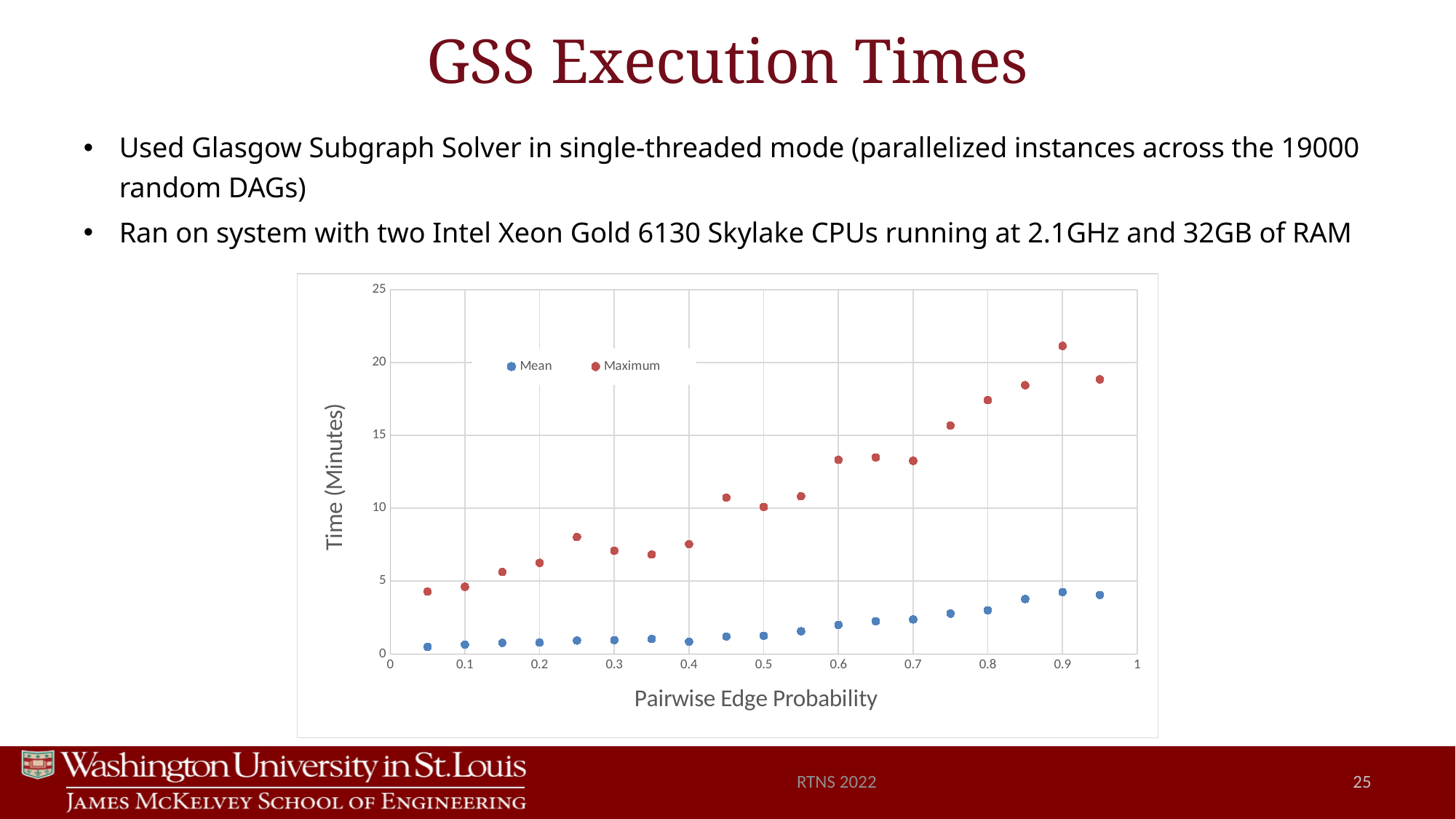
What kind of chart is shown on the slide? scatter plot Is the Maximum value at pairwise edge probability 0.05 greater or less than 5 minutes? less What are the names of the two series in the chart's legend? Mean and Maximum How many series does the chart's legend list? 2 Overall, do the Mean execution times rise or fall as pairwise edge probability increases? rise What is the label of the chart's y axis? Time (Minutes) Is the Maximum value at pairwise edge probability 0.9 greater or less than 20 minutes? greater How many data points are plotted for the Maximum series? 19 At which pairwise edge probability is the Maximum series highest? 0.9 Is the Mean value at pairwise edge probability 0.9 greater or less than 5 minutes? less Which is larger: the Maximum value at pairwise edge probability 0.9 or at 0.95? 0.9